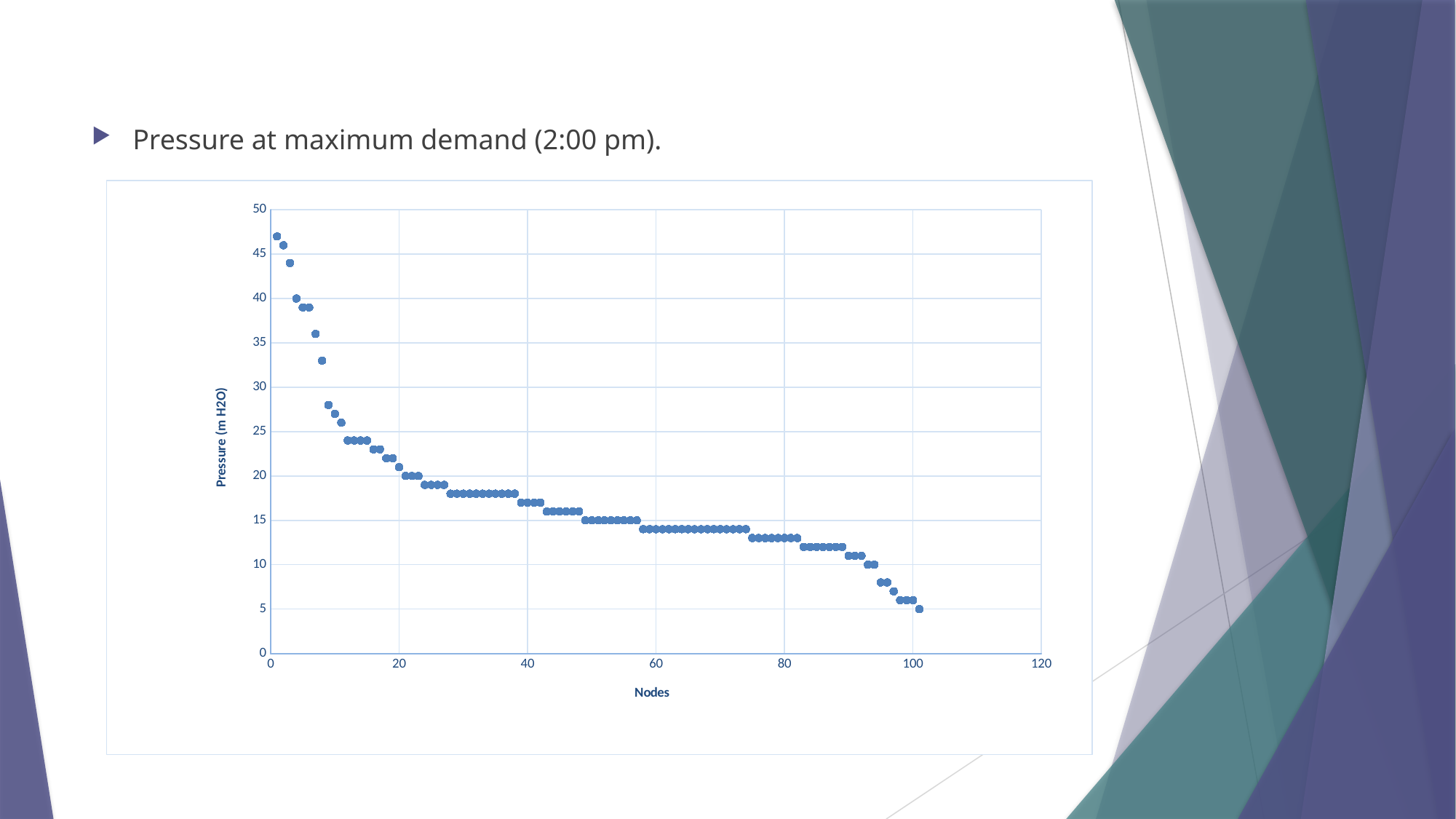
Is the pressure value for node 40 greater or less than 15? greater Which node has a higher pressure value, node 10 or node 90? node 10 Is the pressure value for node 100 greater or less than 10? less Is the pressure value for node 80 greater or less than 15? less What kind of chart is shown on the slide? scatter chart What is the title of the horizontal axis? Nodes What is the title of the vertical axis? Pressure (m H2O) Do the pressure values rise or fall as the node number increases along the x axis? fall